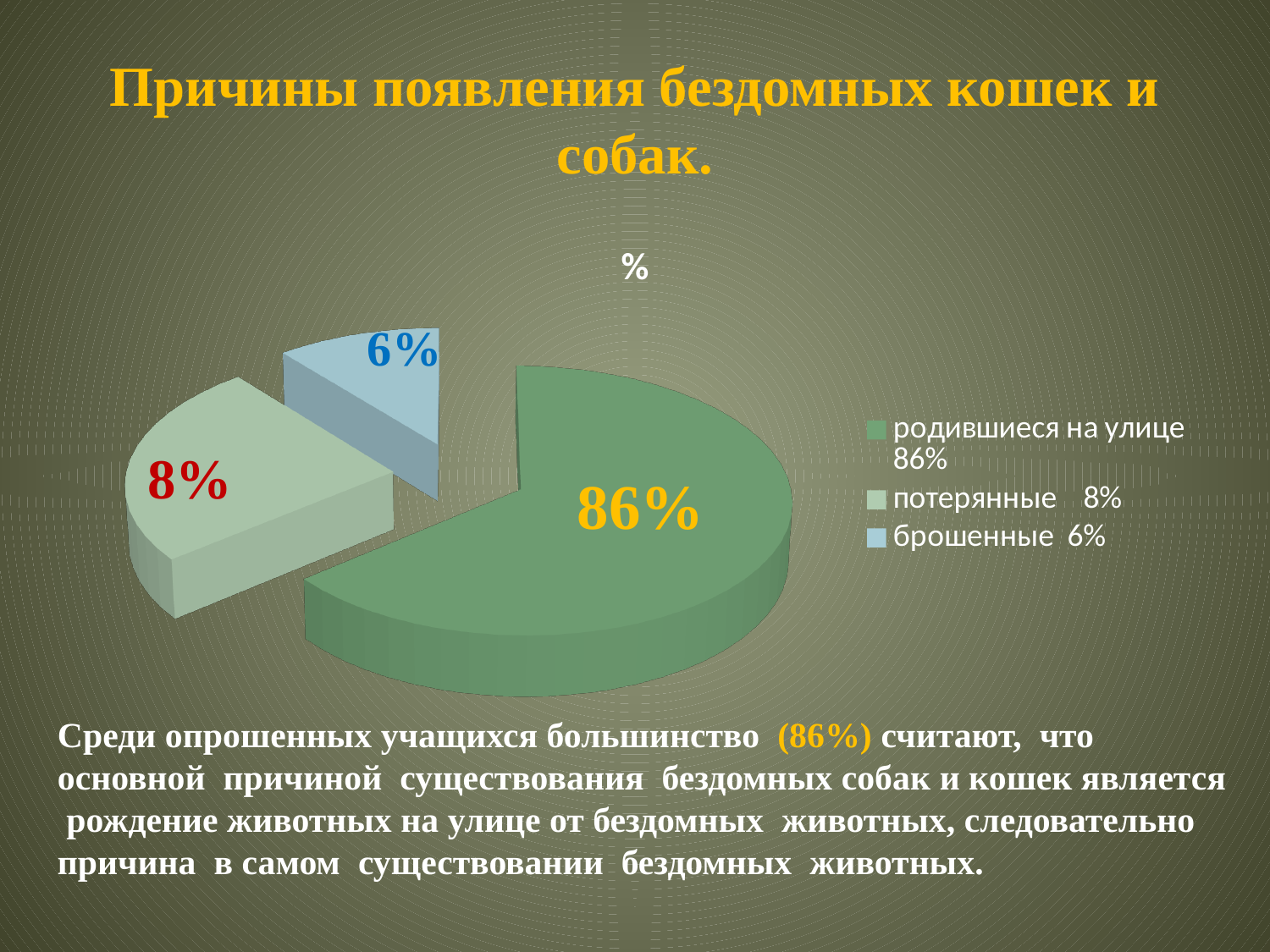
How many entries does the legend list? 3 What is the title shown above the pie chart? % What share of the pie does "родившиеся на улице" have? 86% What is the difference between the shares of "родившиеся на улице" and "потерянные"? 78% Which category has the largest slice of the pie? родившиеся на улице What kind of chart is shown on the slide? pie chart Which is larger, the share of "потерянные" or the share of "брошенные"? потерянные How many slices does the pie chart have? 3 What share of the pie does "брошенные" have? 6% What is the difference between the shares of "потерянные" and "брошенные"? 2% Which category has the smallest slice of the pie? брошенные What share of the pie does "потерянные" have? 8%